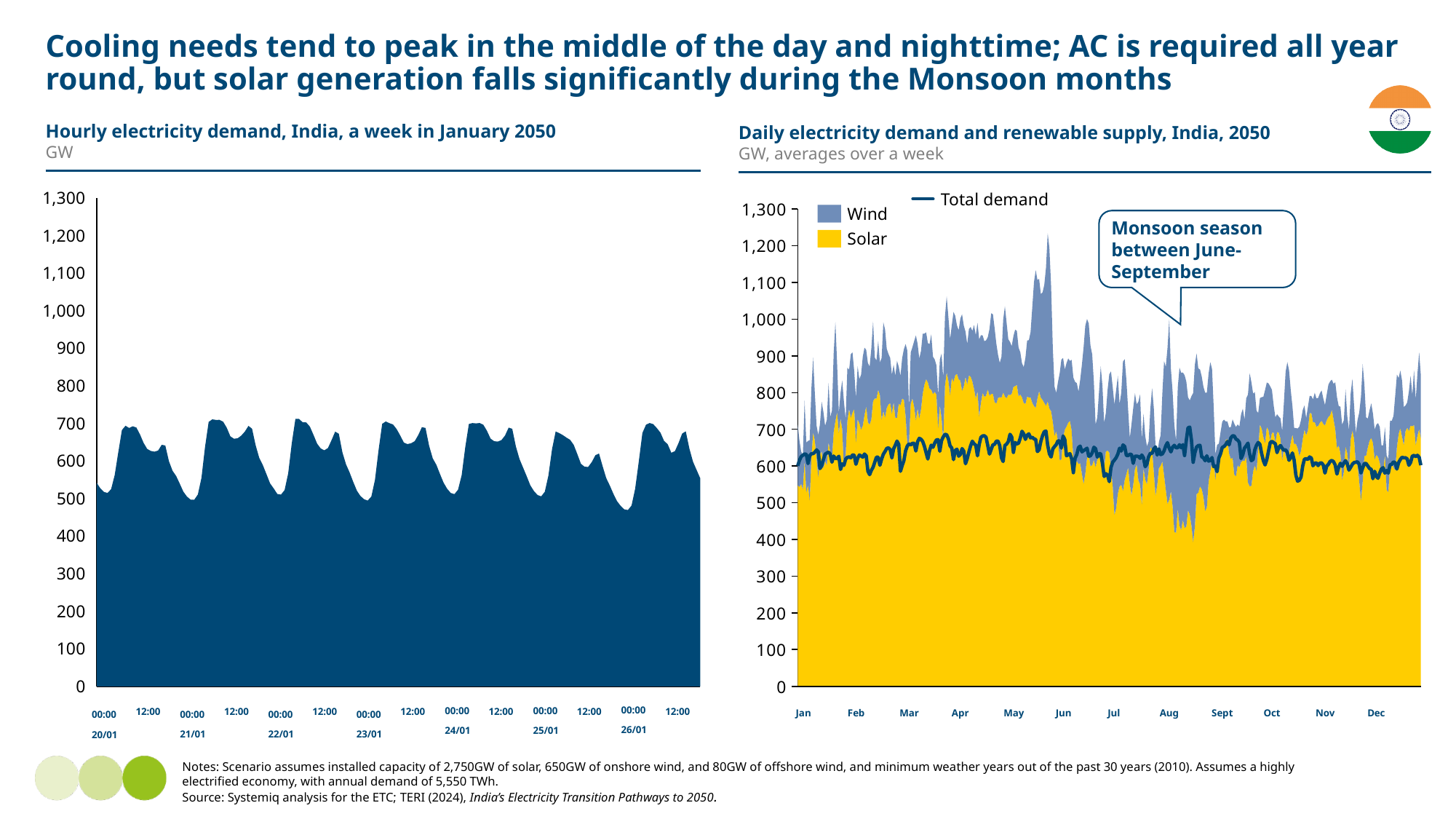
What kind of chart is the right chart, 'Daily electricity demand and renewable supply, India, 2050'? Stacked area chart In the right chart, how many series does the legend list? 3 In the right chart, is the solar supply in August greater or less than 700? less In the right chart, how many months are labelled on the x axis? 12 In the right chart, which series is shown in yellow? Solar What kind of chart is the left chart, 'Hourly electricity demand, India, a week in January 2050'? Area chart In the right chart, is the highest point of combined wind and solar supply in May greater or less than 1,100? greater In the left chart, is the peak demand on 22/01 greater or less than 800? less In the left chart, how many dates are labelled on the x axis? 7 According to the annotation on the right chart, between which months is the Monsoon season? June-September